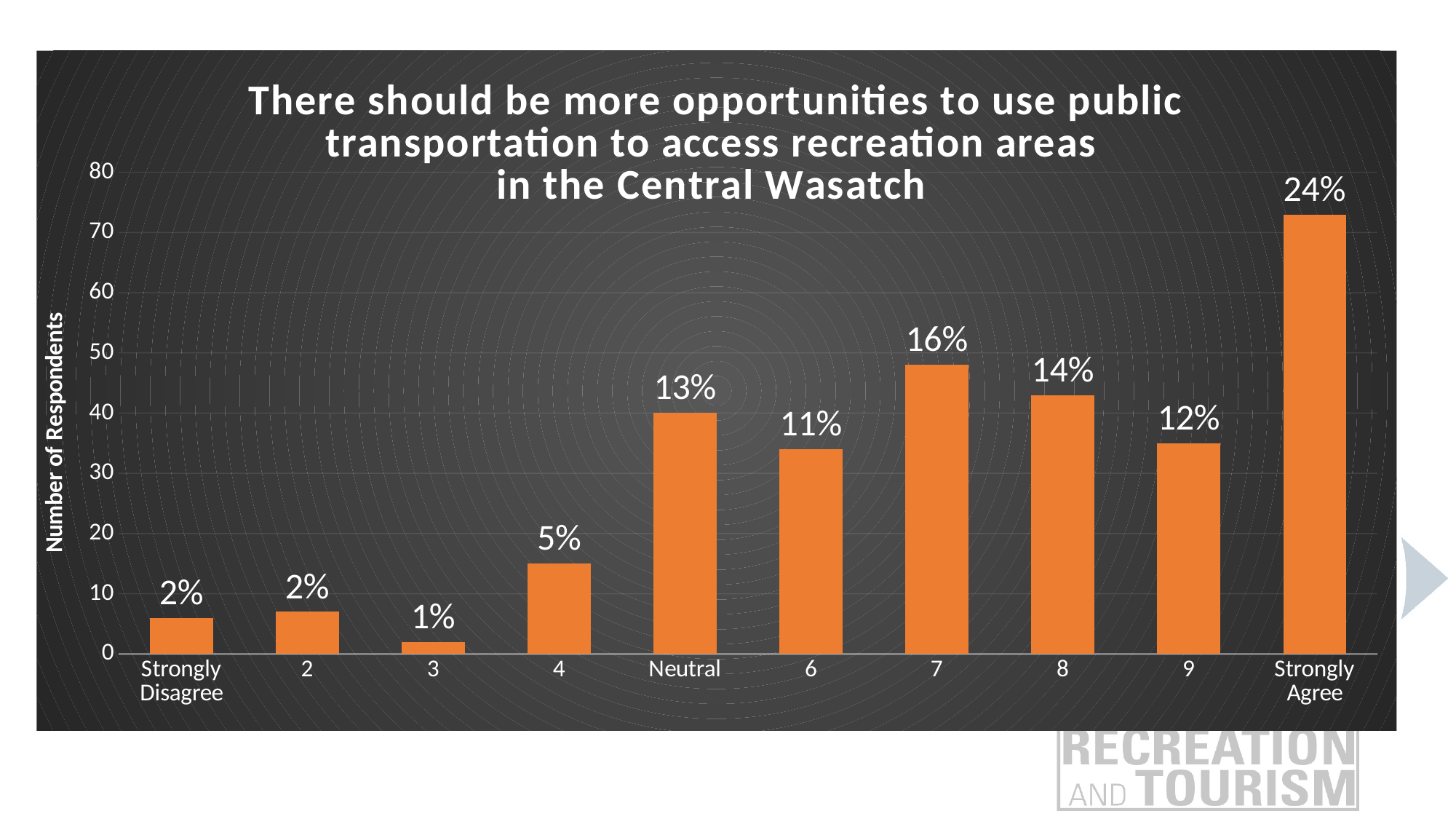
What percentage label is shown on the bar for Strongly Agree? 24% Which category has the highest bar? Strongly Agree What percentage label is shown on the bar for category 3? 1% What is the difference in percentage points between the labels for Strongly Agree and category 7? 8% What kind of chart is shown on the slide? Bar chart Which category has the lowest bar? 3 Is the number of respondents for category 4 greater or less than 20? less What percentage label is shown on the bar for category 7? 16% Which has a larger value, category 8 or category 9? 8 What percentage label is shown on the bar for Neutral? 13% How many categories are shown on the x axis? 10 Is the number of respondents for Strongly Agree greater or less than 70? greater